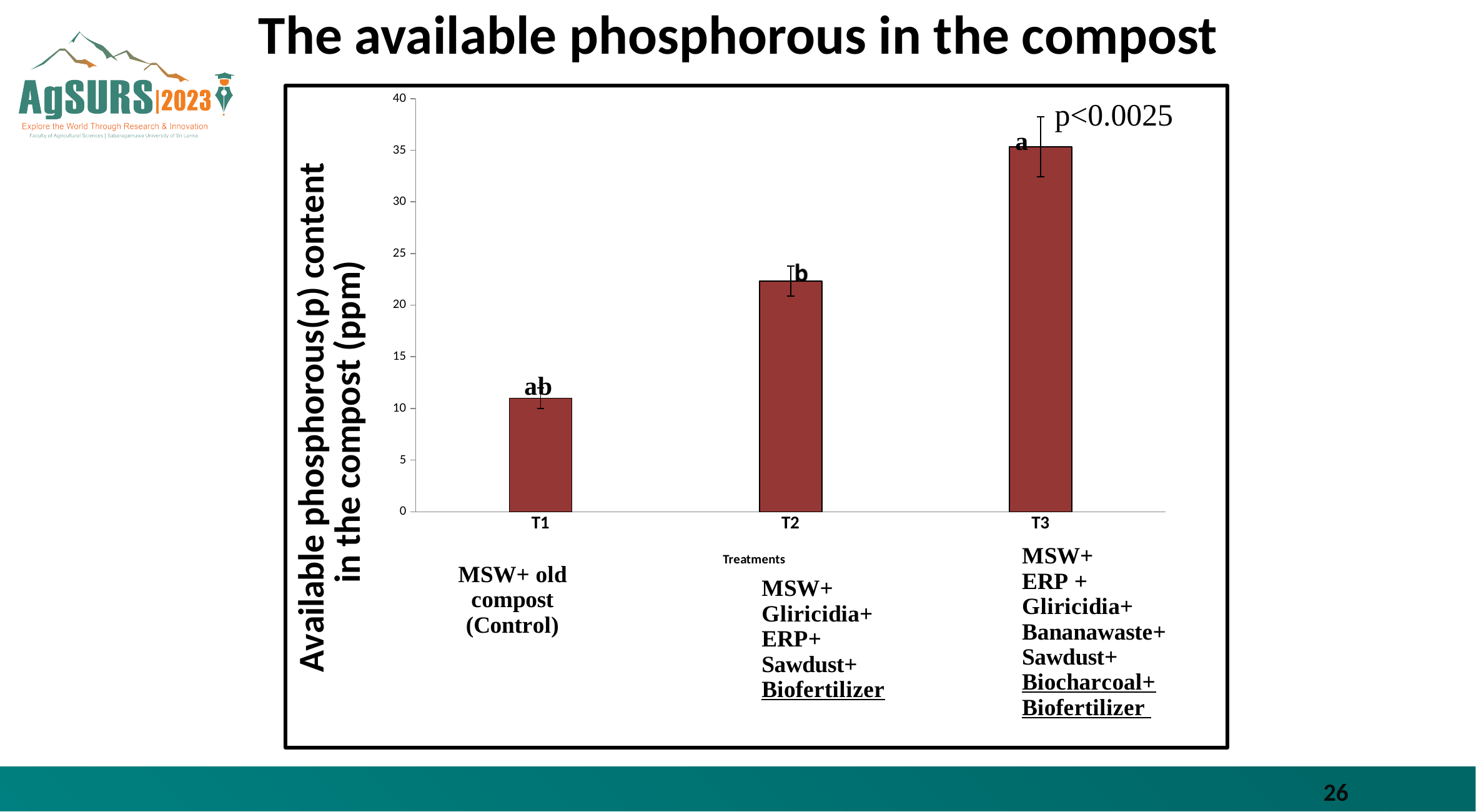
Which treatment has the highest available phosphorous content? T3 Is the value for T2 greater or less than 25? less What is the label on the y axis of the chart? Available phosphorous(p) content in the compost (ppm) What p-value is shown on the chart? p<0.0025 What kind of chart is shown on the slide? bar chart Is the value for T2 greater or less than 20? greater Is the value for T3 greater or less than 30? greater How many treatments (bars) are plotted in the chart? 3 Do the bar values rise or fall from T1 to T3? rise Which treatment has the lowest available phosphorous content? T1 Which has a higher available phosphorous content, T1 or T2? T2